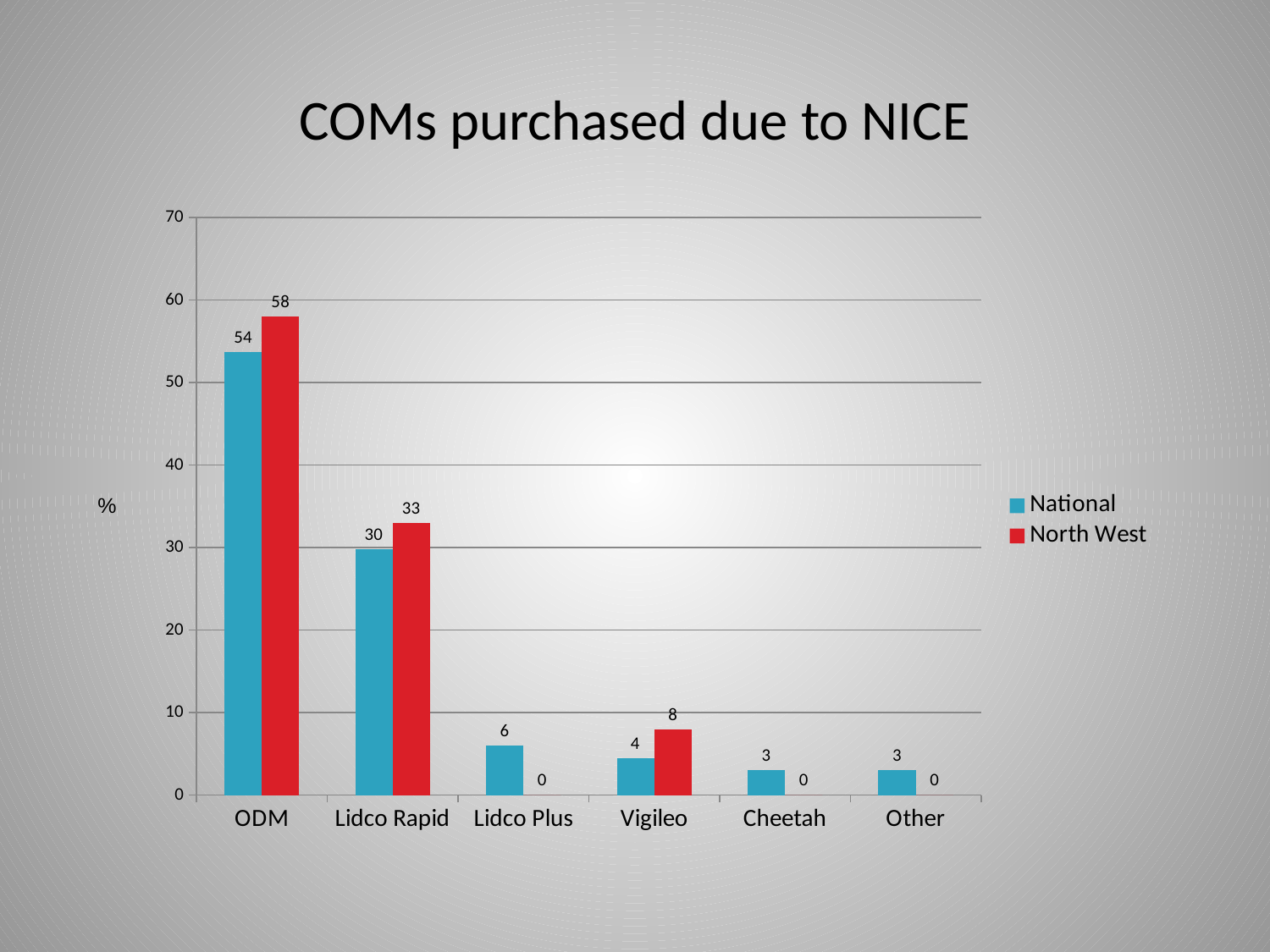
How many categories are shown on the x axis? 6 What is the National value for Vigileo? 4 How many series does the legend list? 2 Which category has the highest North West value? ODM What is the title of the chart? COMs purchased due to NICE What is the North West value for Lidco Plus? 0 What kind of chart is shown? bar chart What is the North West value for Lidco Rapid? 33 Which is larger for Lidco Rapid, the National value or the North West value? North West Is the National value for ODM greater or less than 50? greater What is the difference between the North West and National values for ODM? 4 What is the National value for ODM? 54